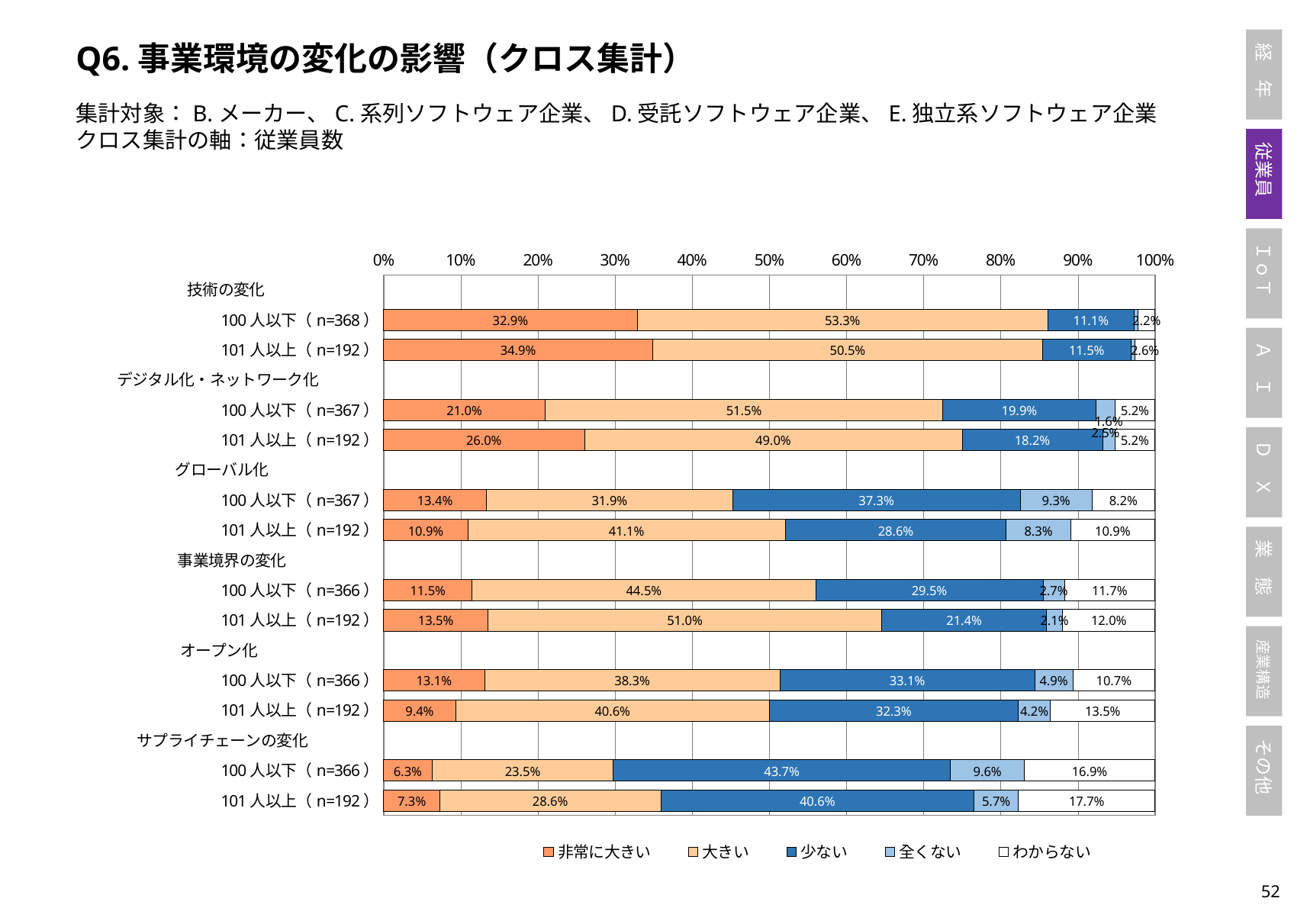
For グローバル化, which has the larger 「少ない」 value: 100人以下 (n=367) or 101人以上 (n=192)? 100人以下 (n=367) What is the difference between the 「大きい」 values for 事業境界の変化 101人以上 (n=192) and 100人以下 (n=366)? 6.5% How many series does the legend list? 5 What is the 「少ない」 value for サプライチェーンの変化, 100人以下 (n=366)? 43.7% What type of chart is shown on the slide? stacked bar chart What is the 「非常に大きい」 value for 技術の変化, 100人以下 (n=368)? 32.9% What is the 「全くない」 value for グローバル化, 100人以下 (n=367)? 9.3% How many bars (rows with data) are plotted in the chart? 12 What is the 「わからない」 value for オープン化, 101人以上 (n=192)? 13.5% Which bar has the highest 「非常に大きい」 value? 技術の変化 101人以上 (n=192) Which bar has the lowest 「非常に大きい」 value? サプライチェーンの変化 100人以下 (n=366) What is the 「大きい」 value for デジタル化・ネットワーク化, 101人以上 (n=192)? 49.0%